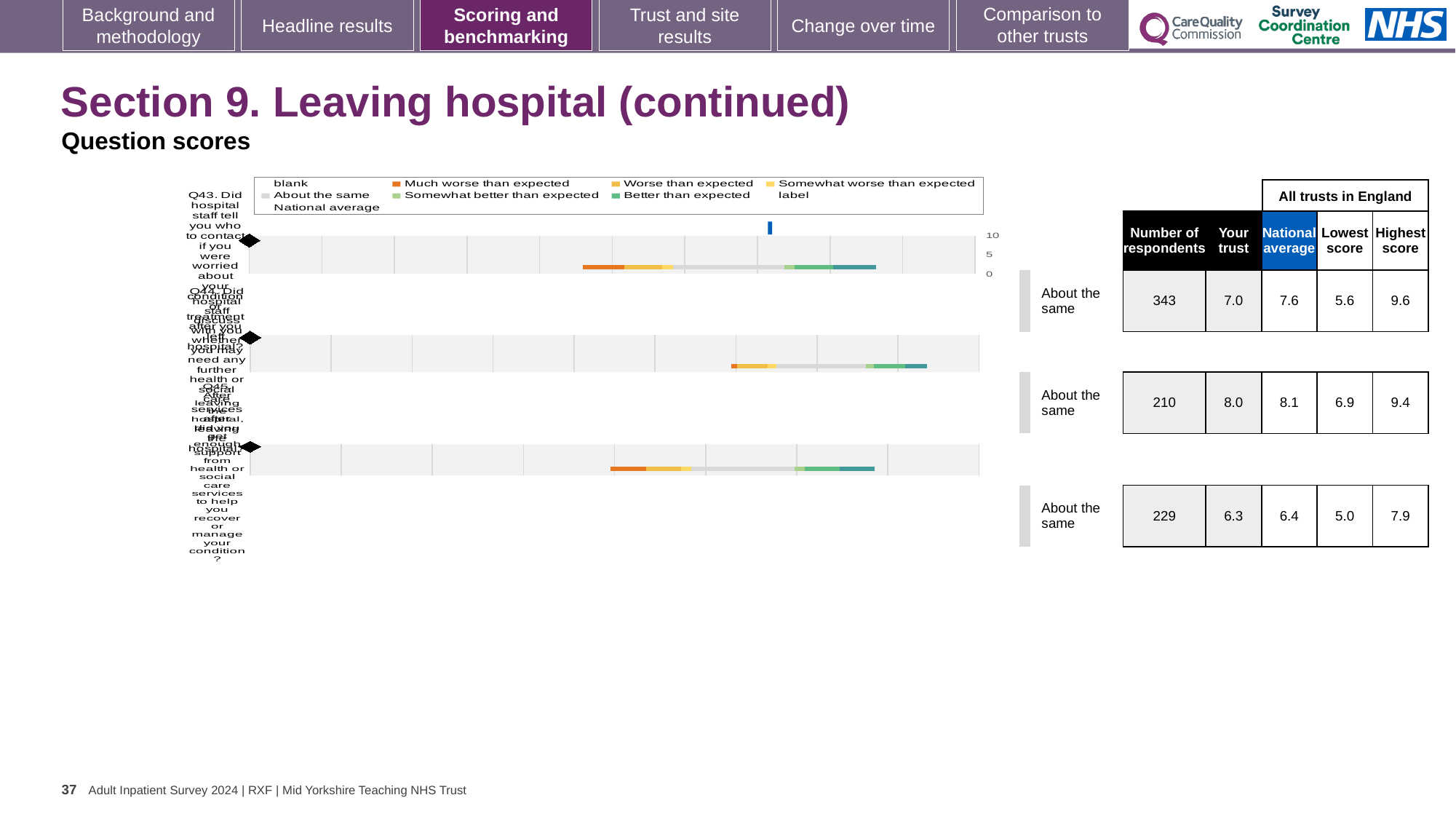
What kind of chart is shown on the slide? bar chart In the table, what is the number of respondents for the first (top) question, Q43? 343 In the table, what is the 'Your trust' score for the first (top) question, Q43? 7.0 Which of the three questions has the highest 'Your trust' score in the table? the second (middle) question, 8.0 For the third (bottom) question, which is larger: the 'Your trust' score or the national average? national average Which of the three questions has the fewest respondents in the table? the second (middle) question, 210 For the first (top) question, Q43, what is the difference between the highest score and the lowest score in the table? 4.0 In the table, what is the lowest score for the third (bottom) question? 5.0 In the table, what is the highest score for the second (middle) question? 9.4 How many questions (bars) are plotted in the chart? 3 In the table, what is the number of respondents for the third (bottom) question? 229 In the table, what is the national average for the first (top) question, Q43? 7.6